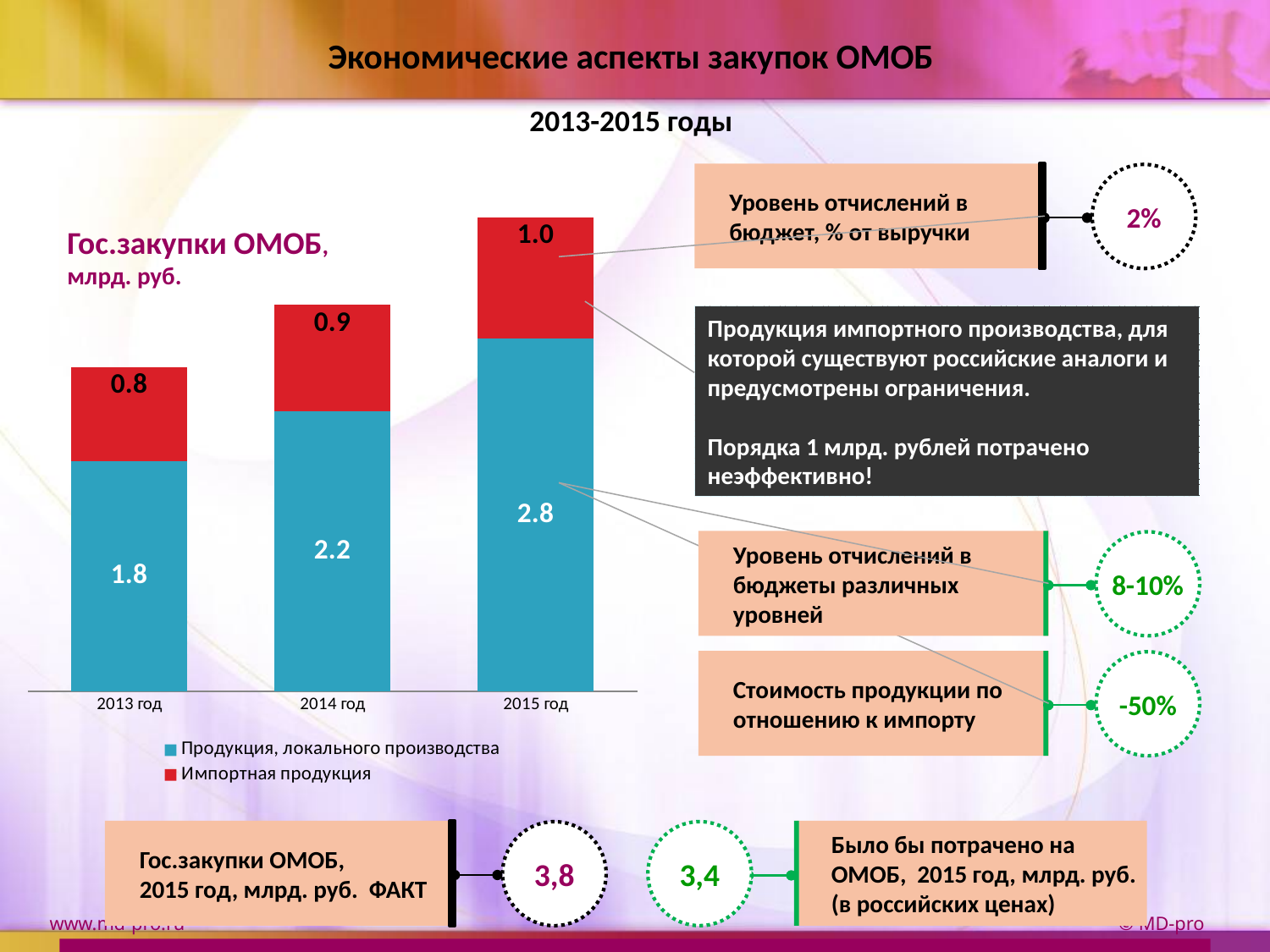
How many series does the legend list? 2 Do the values for Продукция, локального производства rise or fall from 2013 год to 2015 год? Rise Which year has the lowest value for Продукция, локального производства? 2013 год Which year has the highest value for Импортная продукция? 2015 год What is the total of the stacked bar for 2015 год? 3.8 What is the value for Импортная продукция in 2013 год? 0.8 Which is larger: Импортная продукция in 2014 год or in 2013 год? 2014 год What kind of chart is shown on the slide? Stacked bar chart What is the difference between Продукция, локального производства in 2015 год and in 2013 год? 1.0 What is the value for Продукция, локального производства in 2015 год? 2.8 How many years are shown on the x axis of the chart? 3 What is the value for Продукция, локального производства in 2014 год? 2.2